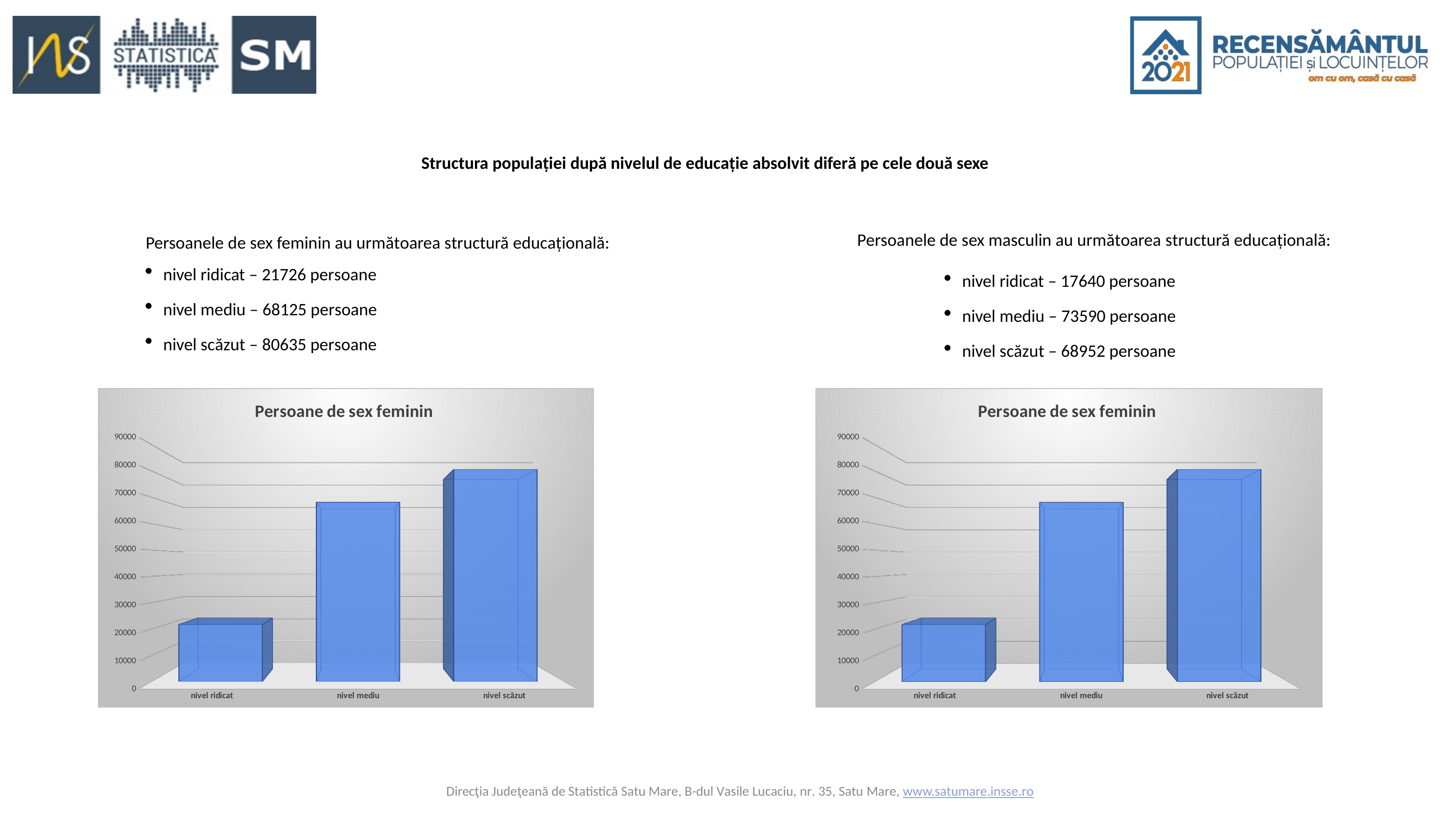
In the left chart, is the value for nivel scăzut greater or less than 70000? greater In the left chart, do the values rise or fall from nivel ridicat to nivel scăzut along the x axis? rise In the right chart, is the value for nivel mediu greater or less than 60000? greater In the left chart, which category has the highest bar? nivel scăzut In the right chart, which category has the highest bar? nivel scăzut In the left chart, which category has the lowest bar? nivel ridicat In the left chart, is the value for nivel ridicat greater or less than 30000? less In the right chart, which category has the lowest bar? nivel ridicat What is the title of the left chart? Persoane de sex feminin In the right chart, is the bar for nivel mediu taller or shorter than the bar for nivel ridicat? taller What kind of chart is the left chart on the slide? bar chart How many categories are shown on the x axis of the left chart? 3